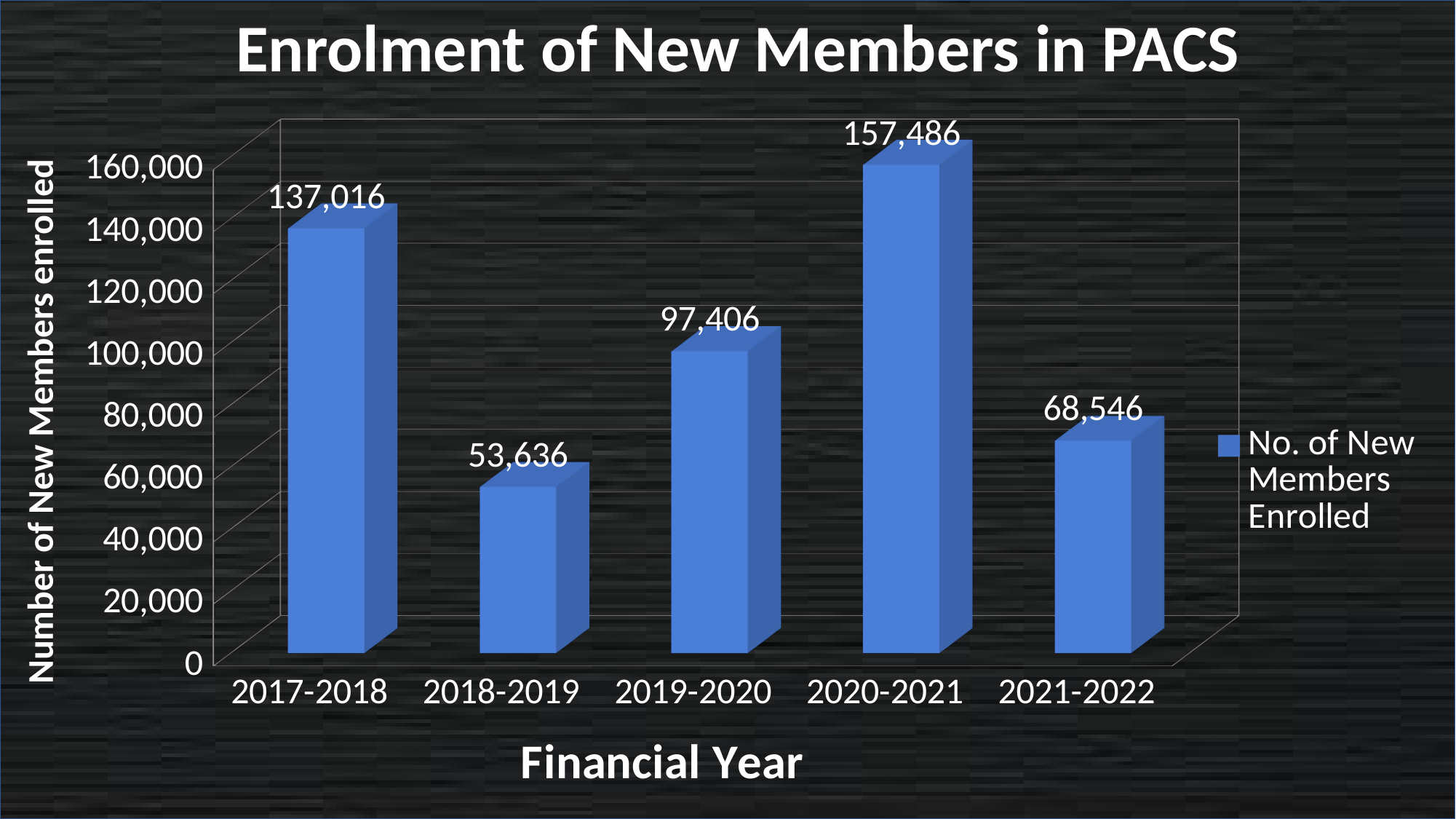
How many financial years are shown on the chart? 5 What is the number of new members enrolled in 2021-2022? 68,546 What is the difference in new members enrolled between 2020-2021 and 2017-2018? 20,470 What is the number of new members enrolled in 2018-2019? 53,636 What kind of chart is shown on the slide? Bar chart Which year had more new members enrolled, 2019-2020 or 2021-2022? 2019-2020 Which financial year had the lowest number of new members enrolled? 2018-2019 What is the difference in new members enrolled between 2019-2020 and 2018-2019? 43,770 What is the number of new members enrolled in 2020-2021? 157,486 Which financial year had the highest number of new members enrolled? 2020-2021 What is the title of the chart? Enrolment of New Members in PACS What is the number of new members enrolled in 2017-2018? 137,016